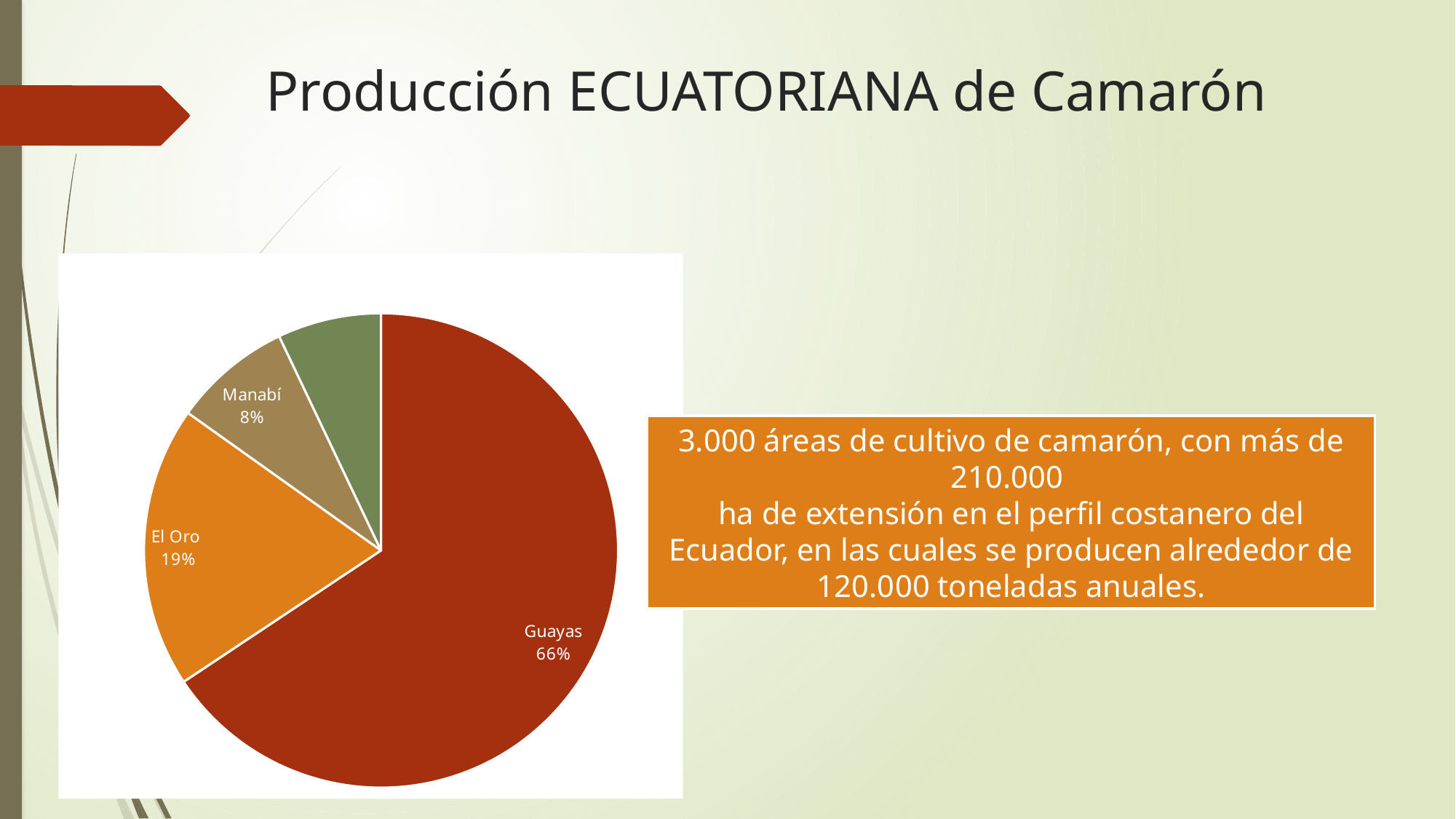
Which labeled slice of the pie is the largest? Guayas How many slices does the pie chart have? 4 What share of the pie does Guayas represent? 66% What is the value shown for El Oro? 19% What colour is the Guayas slice of the pie? dark red What is the difference between the El Oro share and the Manabí share? 11% What kind of chart is shown on the slide? pie chart What is the difference between the Guayas share and the El Oro share? 47% What is the value shown for Manabí? 8% Which is larger, the slice for El Oro or the slice for Manabí? El Oro